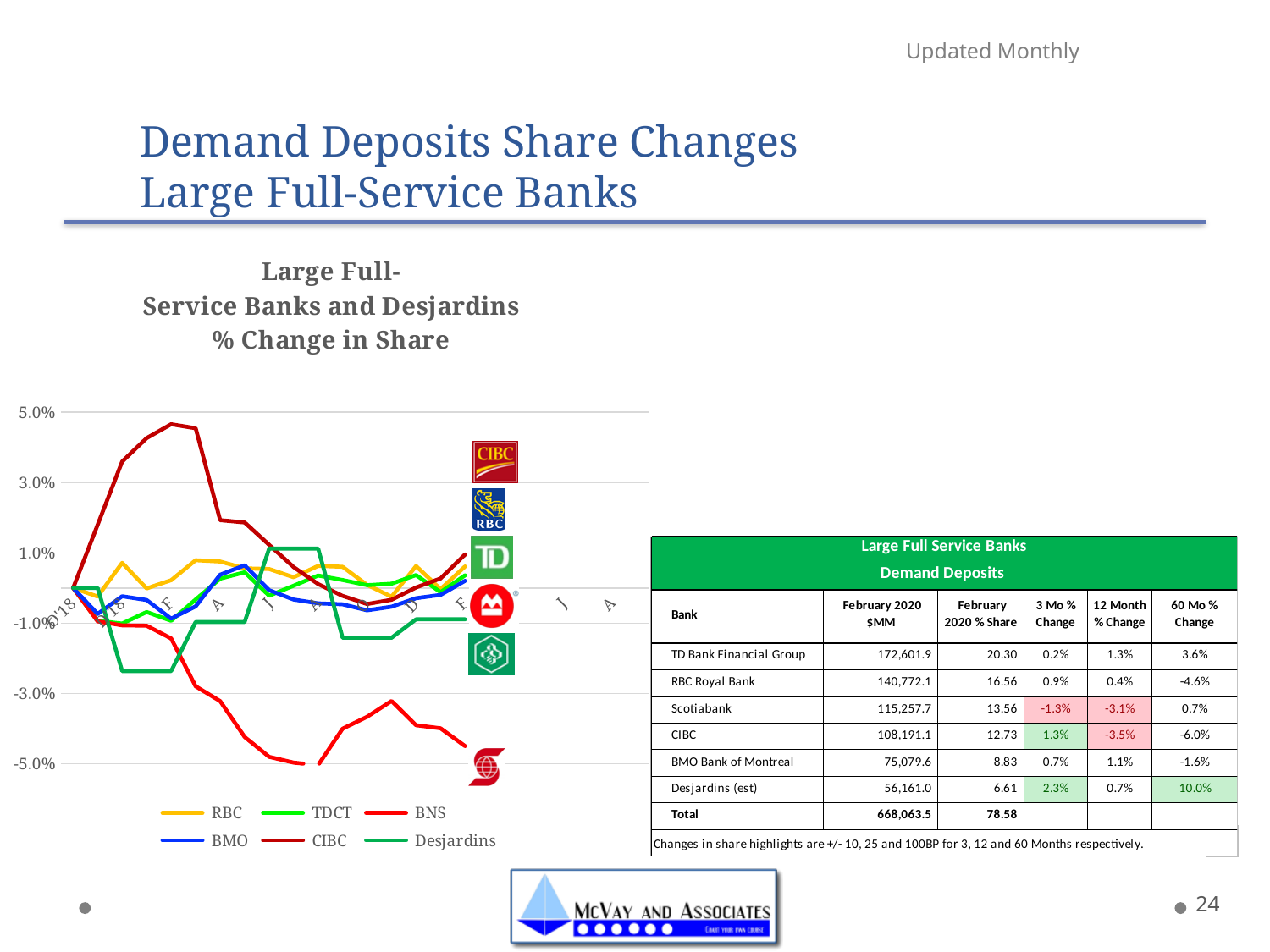
How many series does the chart's legend list? 6 What is the lowest value labelled on the chart's vertical axis? -5.0% What is the highest value labelled on the chart's vertical axis? 5.0% What kind of chart is shown on the slide? Line chart Is the lowest point reached by any line on the chart greater or less than -3.0%? less Is the highest point reached by any line on the chart greater or less than 3.0%? greater Which series are listed in the chart's legend? RBC, TDCT, BNS, BMO, CIBC, Desjardins What is the title of the chart? Large Full-Service Banks and Desjardins % Change in Share